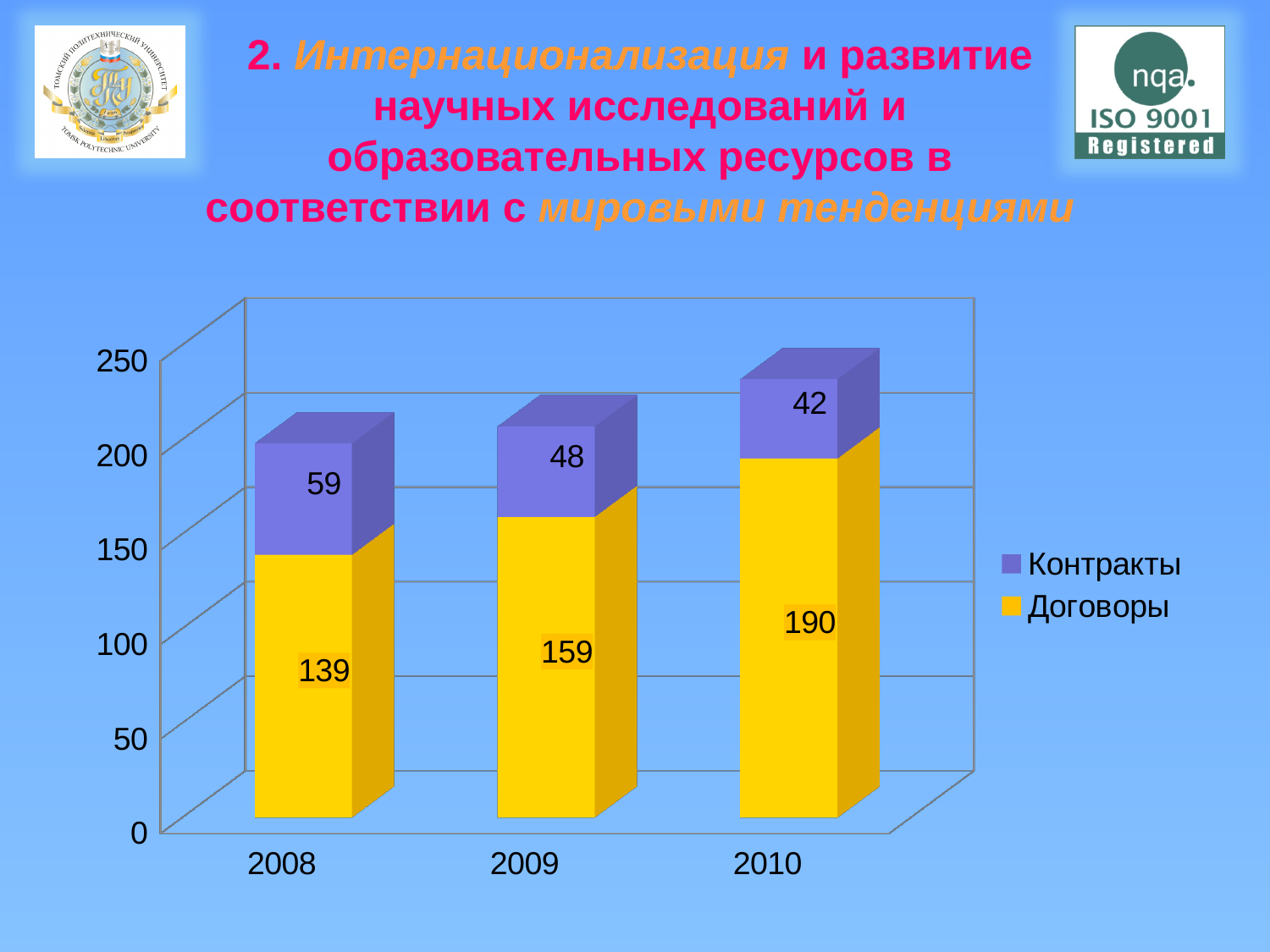
What is the value of Контракты for 2010? 42 Which year has the lowest value for Контракты? 2010 Do the values for Договоры rise or fall from 2008 to 2010? Rise What is the value of Договоры for 2008? 139 What is the value of Договоры for 2009? 159 How many years are shown on the x axis? 3 What is the difference between Договоры in 2010 and Договоры in 2008? 51 Which year has the highest value for Договоры? 2010 What is the total of the stacked bar for 2009? 207 Which is larger: Контракты in 2008 or Контракты in 2009? Контракты in 2008 How many series does the legend list? 2 What kind of chart is shown on the slide? Stacked bar chart